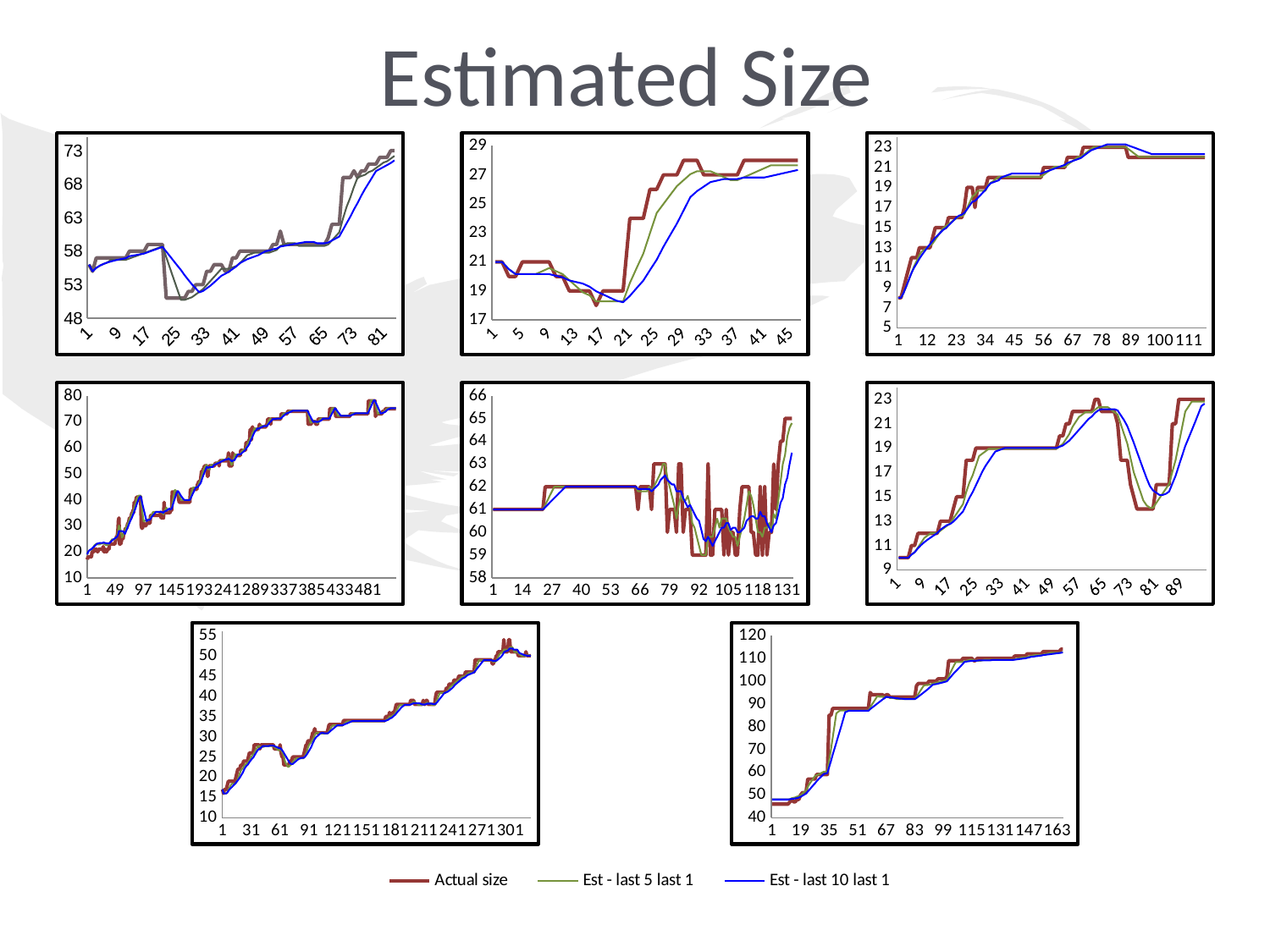
In the middle-right chart, is the Actual size value at x = 1 greater or less than 13? less What kind of chart is used in each of the panels on this slide? Line chart What is the title of the slide? Estimated Size According to the legend, which series is drawn in blue? Est - last 10 last 1 In the bottom-right chart, is the Actual size value at x = 1 greater or less than 50? less In the top-right chart, do the values generally rise or fall from left to right along the x axis? Rise In the top-left chart, is the Actual size value at the right end of the series greater or less than 68? greater How many charts are shown on the slide? 8 In the bottom-left chart, do the values generally rise or fall from left to right along the x axis? Rise How many series does the shared legend at the bottom of the slide list? 3